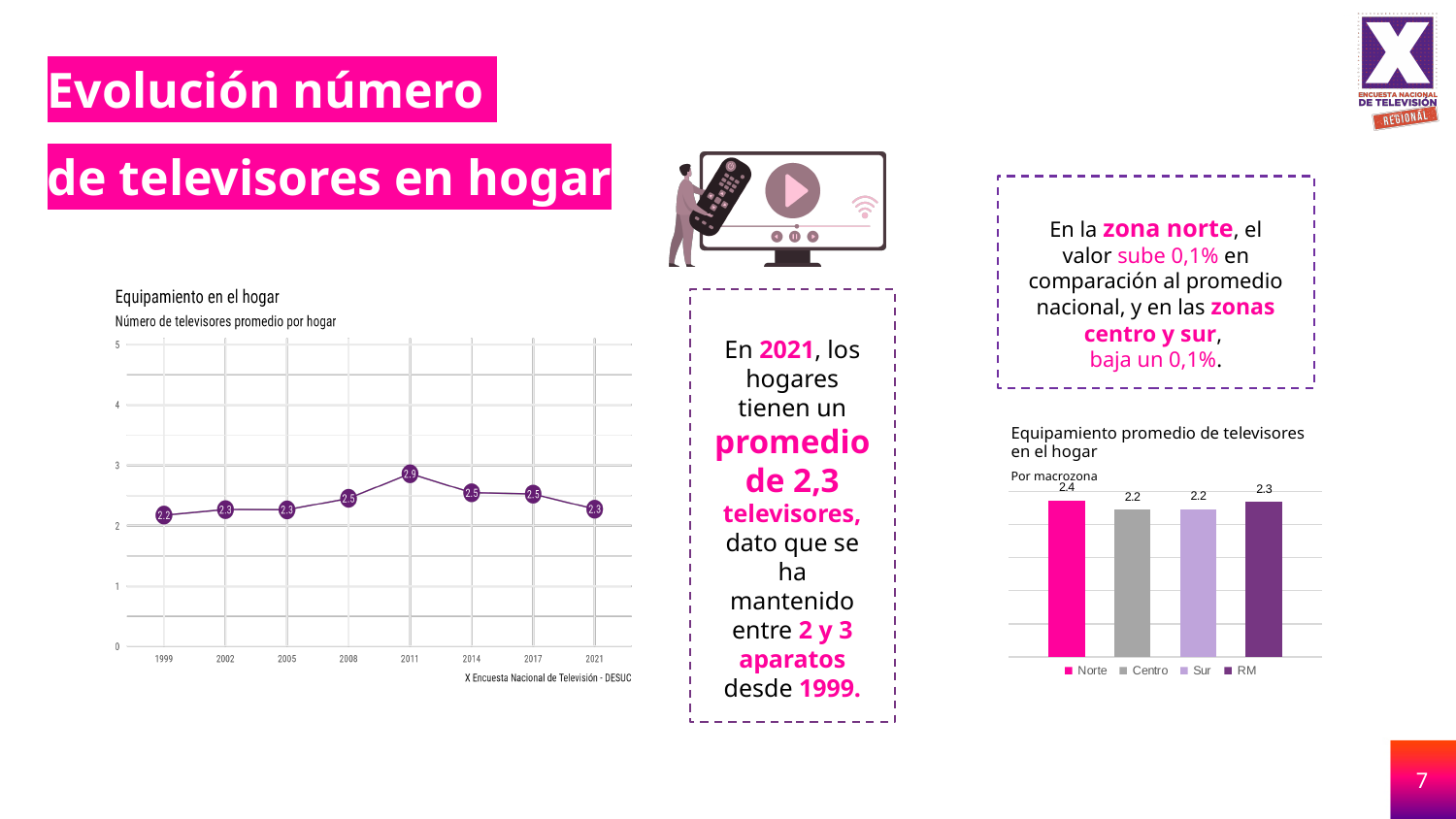
In the bar chart 'Equipamiento promedio de televisores en el hogar', which macrozona has the highest value? Norte In the line chart 'Equipamiento en el hogar', what is the value for 2011? 2.9 In the bar chart 'Equipamiento promedio de televisores en el hogar', how many entries does the legend list? 4 In the line chart 'Equipamiento en el hogar', what is the value for 1999? 2.2 In the line chart 'Equipamiento en el hogar', is the value for 2008 greater or less than 3? less In the line chart 'Equipamiento en el hogar', how many years are plotted? 8 In the line chart 'Equipamiento en el hogar', which year has the highest value? 2011 In the bar chart 'Equipamiento promedio de televisores en el hogar', what is the value for Norte? 2.4 In the line chart 'Equipamiento en el hogar', what is the difference between the values for 2011 and 2021? 0.6 In the bar chart 'Equipamiento promedio de televisores en el hogar', what is the difference between Norte and RM? 0.1 In the line chart 'Equipamiento en el hogar', which year has the lowest value? 1999 What kind of chart is the chart on the right titled 'Equipamiento promedio de televisores en el hogar'? bar chart